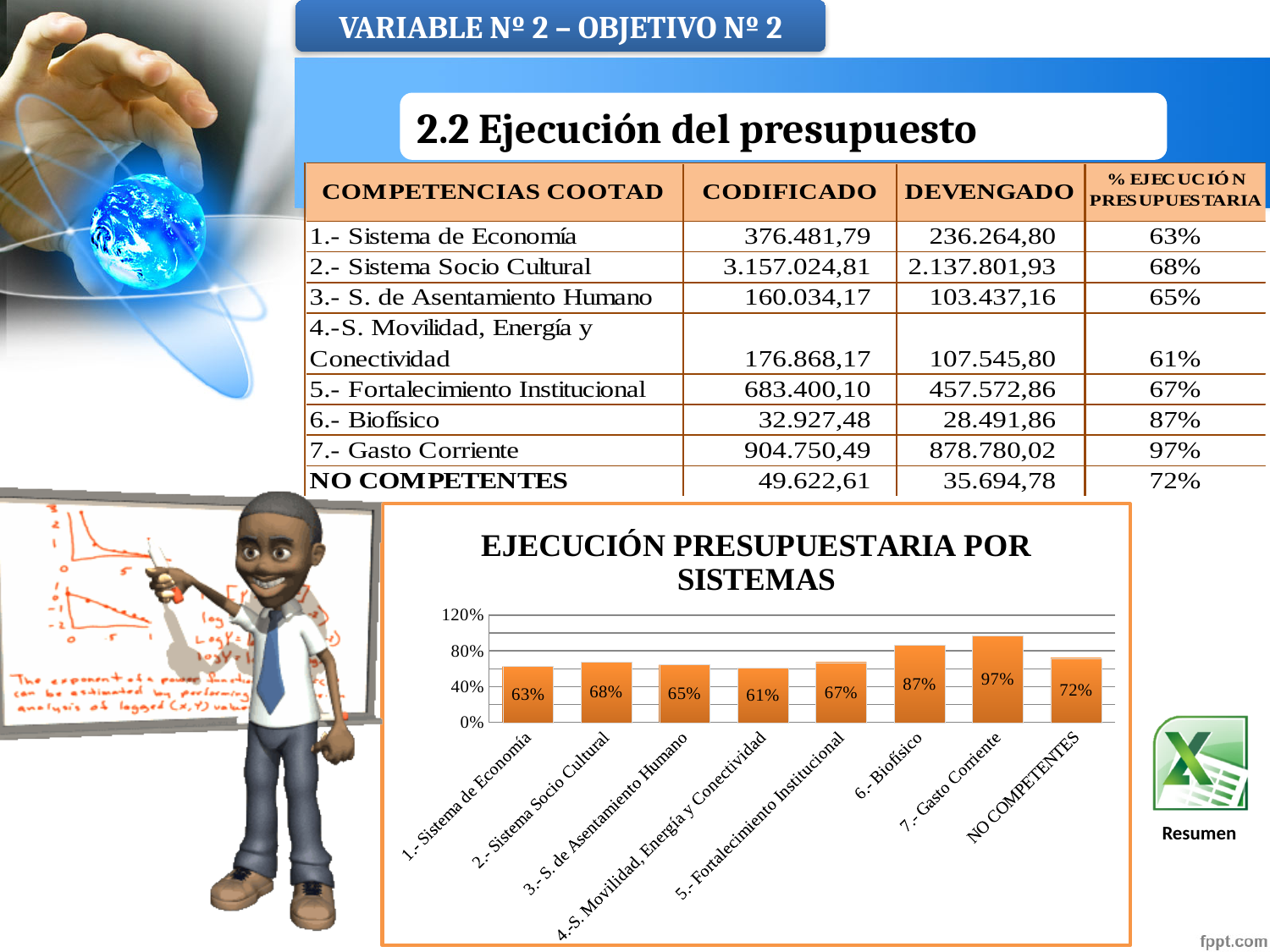
Which category has the highest value in the chart? 7.- Gasto Corriente How many categories are shown on the x axis of the chart? 8 Is the value for 7.- Gasto Corriente greater or less than 80%? greater What kind of chart is shown on the slide? bar chart What is the title of the chart? EJECUCIÓN PRESUPUESTARIA POR SISTEMAS What is the value for NO COMPETENTES in the chart? 72% What is the value for 6.- Biofísico in the chart? 87% What is the difference between the values for 7.- Gasto Corriente and 6.- Biofísico? 10% What is the value for 1.- Sistema de Economía in the chart? 63% Which category has the lowest value in the chart? 4.-S. Movilidad, Energía y Conectividad Which is larger, the value for 2.- Sistema Socio Cultural or the value for 5.- Fortalecimiento Institucional? 2.- Sistema Socio Cultural What is the highest value shown on the y axis of the chart? 120%